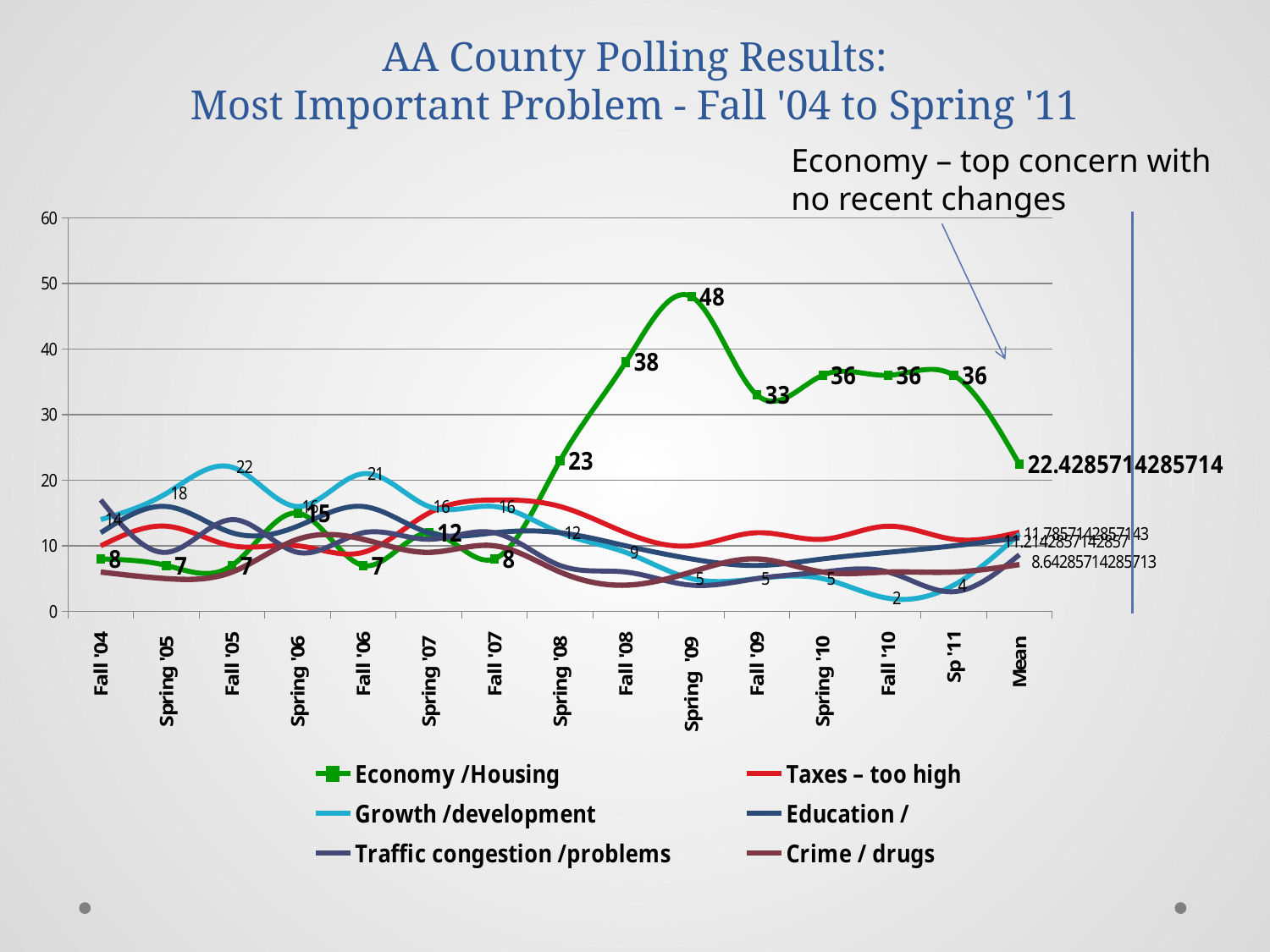
What is the Mean value shown for Economy /Housing? 22.4285714285714 What kind of chart is shown on the slide? line chart What is the difference between the Economy /Housing values for Spring '09 and Fall '08? 10 How many series does the legend list? 6 How many categories are shown along the x axis? 15 Does the Economy /Housing line rise or fall from Spring '08 to Spring '09? rise What is the difference between the Economy /Housing values for Spring '09 and Fall '09? 15 Which is larger for Economy /Housing: the value in Spring '08 or the value in Fall '08? Fall '08 In which period does Economy /Housing reach its highest value? Spring '09 What is the value for Economy /Housing in Spring '09? 48 What is the value for Economy /Housing in Fall '04? 8 Is the value for Taxes – too high in Spring '09 greater or less than 20? less